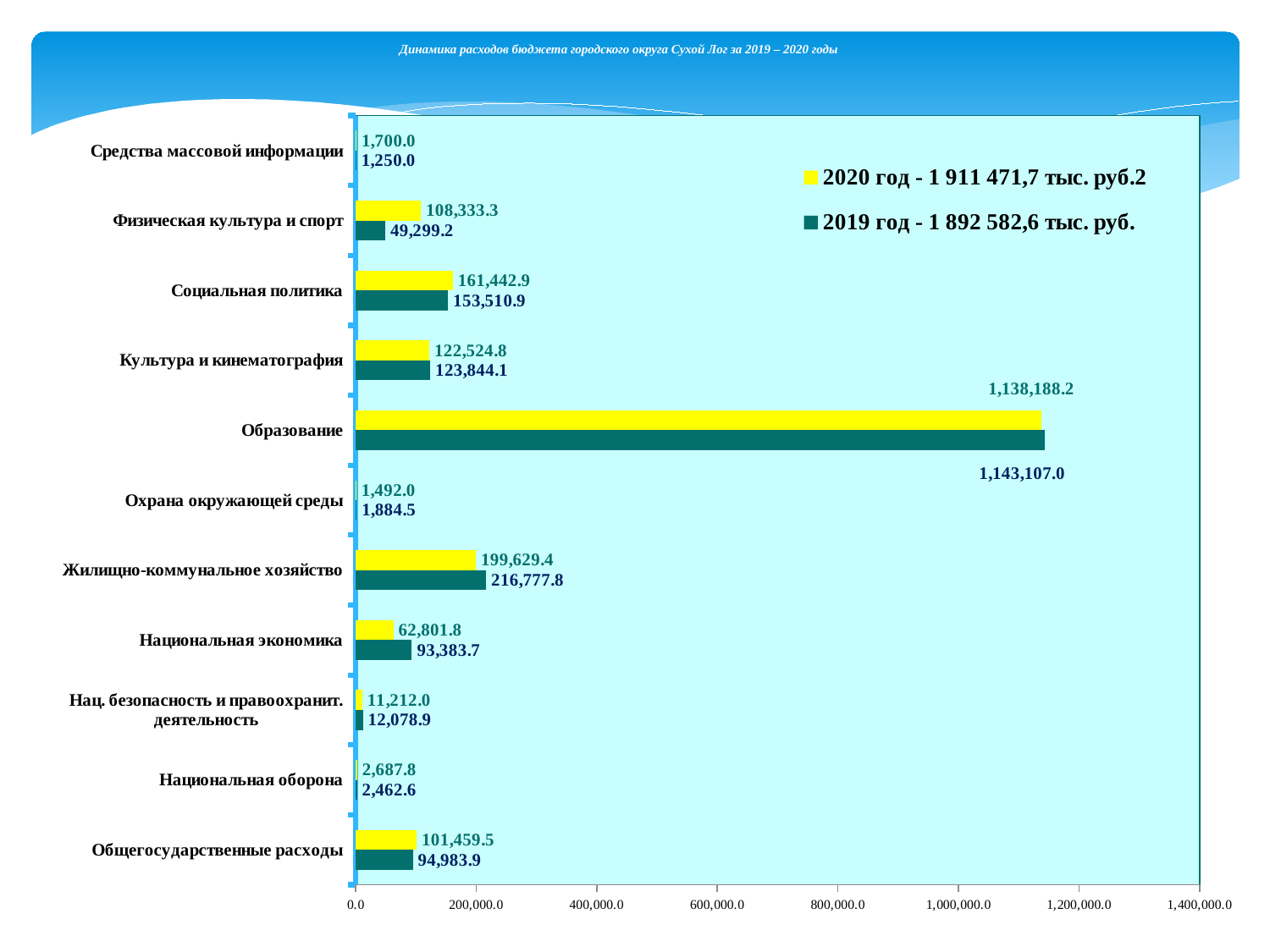
How many series does the legend list? 2 Which category has the lowest 2019 value? Средства массовой информации Which category has the highest 2019 value? Образование What is the 2020 value for Образование? 1,138,188.2 What is the difference between the 2020 and 2019 values for Физическая культура и спорт? 59,034.1 What is the 2019 value for Жилищно-коммунальное хозяйство? 216,777.8 What is the difference between the 2019 and 2020 values for Национальная экономика? 30,581.9 What type of chart is shown on the slide? bar chart How many categories are shown on the chart? 11 What total is given in the legend for 2019 год? 1 892 582,6 тыс. руб. Which is larger for Общегосударственные расходы: the 2020 value or the 2019 value? 2020 What is the 2020 value for Физическая культура и спорт? 108,333.3